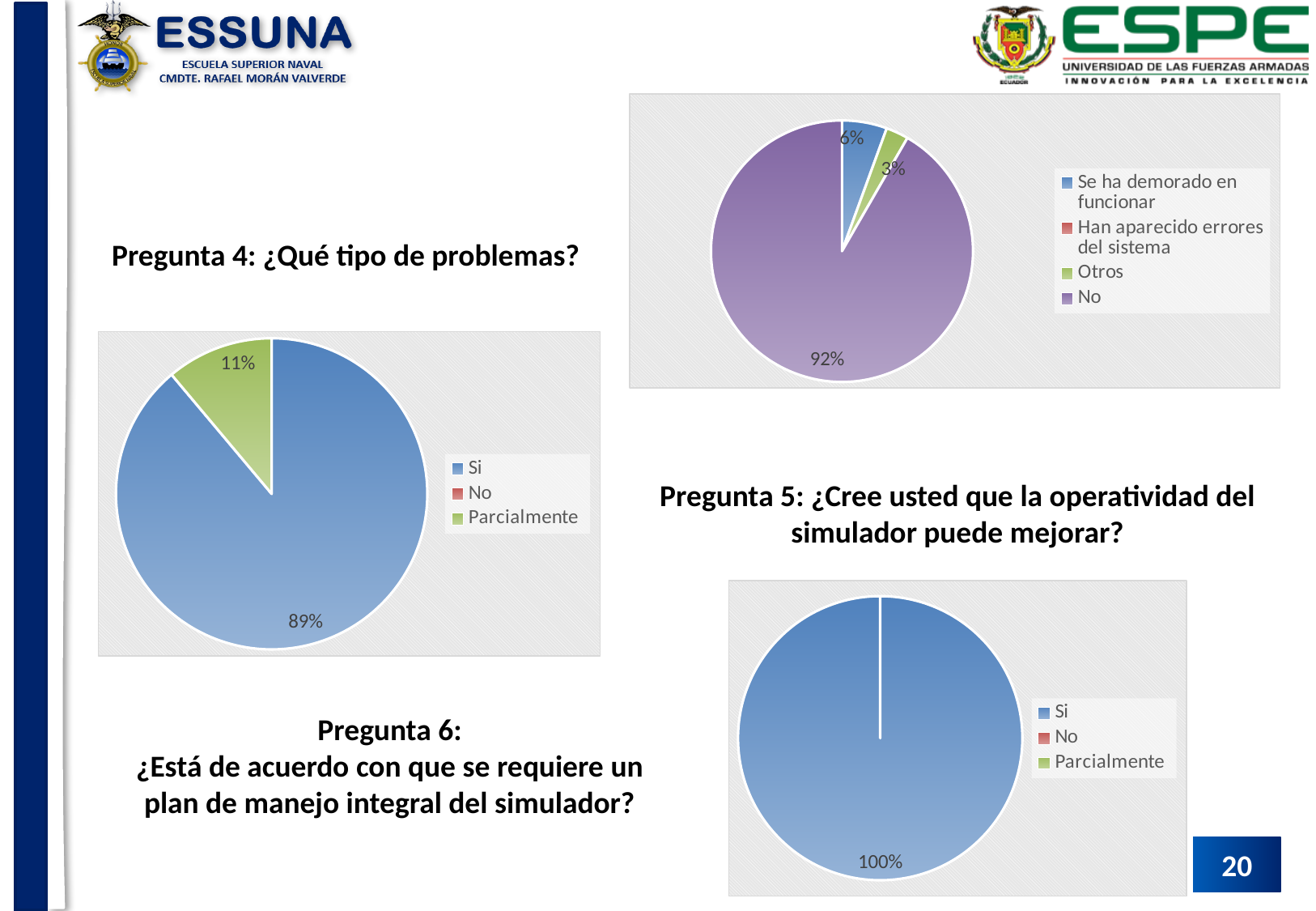
How many entries does the legend of the top-right pie chart list? 4 In the left pie chart, what is the difference between the 'Si' share and the 'Parcialmente' share? 78% In the top-right pie chart, what share does the 'No' slice have? 92% In the top-right pie chart, which is larger, 'Se ha demorado en funcionar' or 'Otros'? Se ha demorado en funcionar In the top-right pie chart, what share does the 'Se ha demorado en funcionar' slice have? 6% In the bottom-right pie chart, what share does the 'Si' slice have? 100% In the top-right pie chart, what share does the 'Otros' slice have? 3% In the top-right pie chart, which category has the largest slice? No In the left pie chart, what share does the 'Si' slice have? 89% In the left pie chart, what share does the 'Parcialmente' slice have? 11% What kind of chart is the top-right chart on the slide? pie chart How many entries does the legend of the bottom-right pie chart list? 3